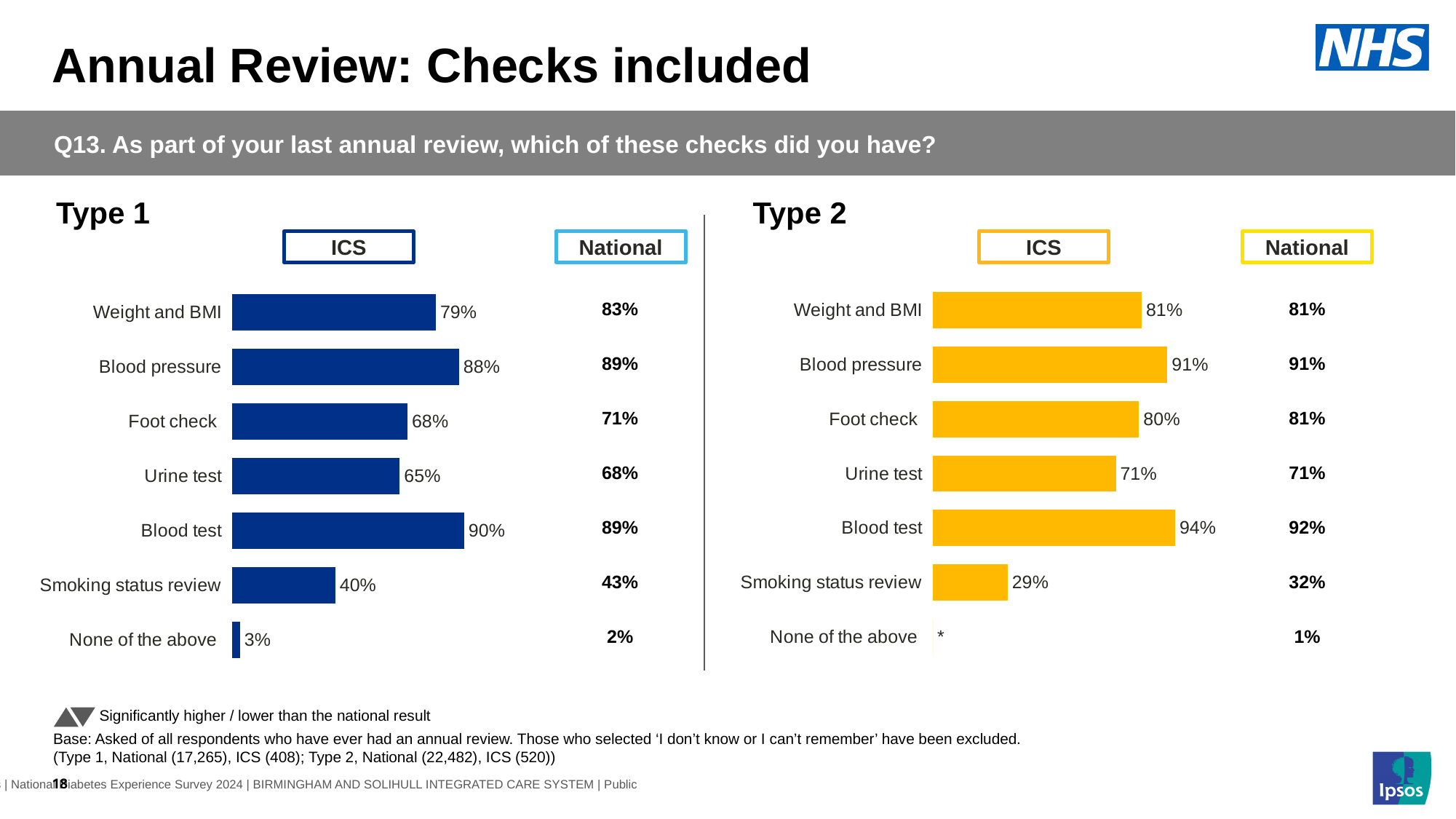
In the Type 2 chart, what is the National value for Blood test? 92% In the Type 1 chart, is the ICS value for Urine test higher or lower than the ICS value for Foot check? lower In the Type 1 chart, what is the ICS value for Blood pressure? 88% In the Type 2 chart, what is the ICS value for Smoking status review? 29% In the Type 1 chart, what is the difference between the ICS and National values for Weight and BMI? 4 percentage points In the Type 2 chart, what is the difference between the ICS values for Blood test and Urine test? 23 percentage points How many checks are listed in the Type 2 chart? 7 In the Type 2 chart, which check has the lowest ICS value among those with a printed percentage? Smoking status review In the Type 1 chart, which check has the highest ICS value? Blood test What type of chart is used for the Type 1 ICS results? bar chart In the Type 1 chart, what is the National value for Foot check? 71% What colour are the ICS bars in the Type 2 chart? yellow